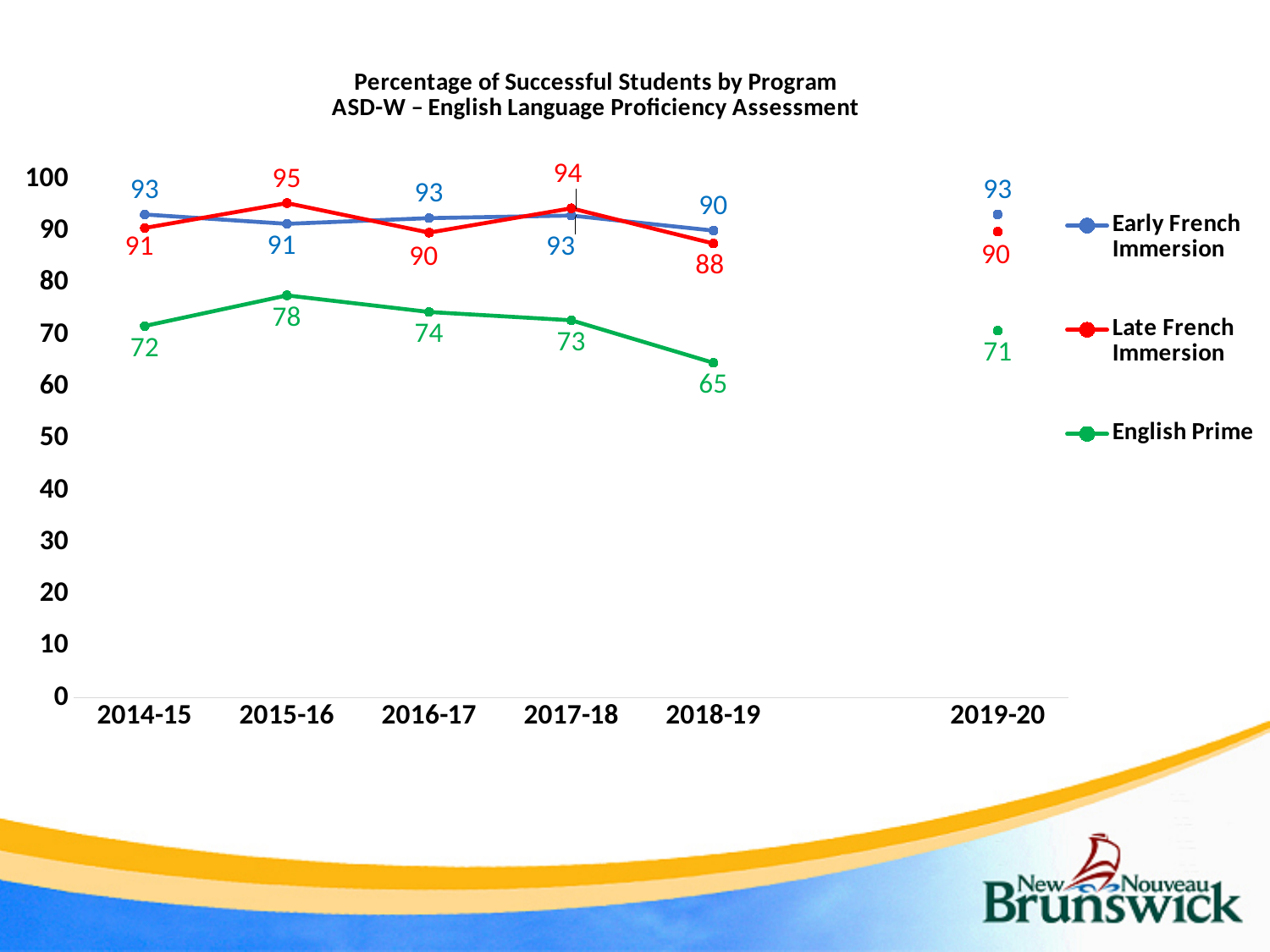
What is the value for Early French Immersion in 2019-20? 93 What is the difference between the Early French Immersion and English Prime values in 2018-19? 25 What is the value for Late French Immersion in 2018-19? 88 In which year is the Late French Immersion value highest? 2015-16 What is the value for English Prime in 2018-19? 65 In which year is the English Prime value lowest? 2018-19 How many school years are shown on the x axis? 6 In 2017-18, which is larger: Late French Immersion or Early French Immersion? Late French Immersion Does the English Prime value rise or fall from 2017-18 to 2018-19? fall How many series does the legend list? 3 What is the value for Late French Immersion in 2015-16? 95 What kind of chart is this? line chart